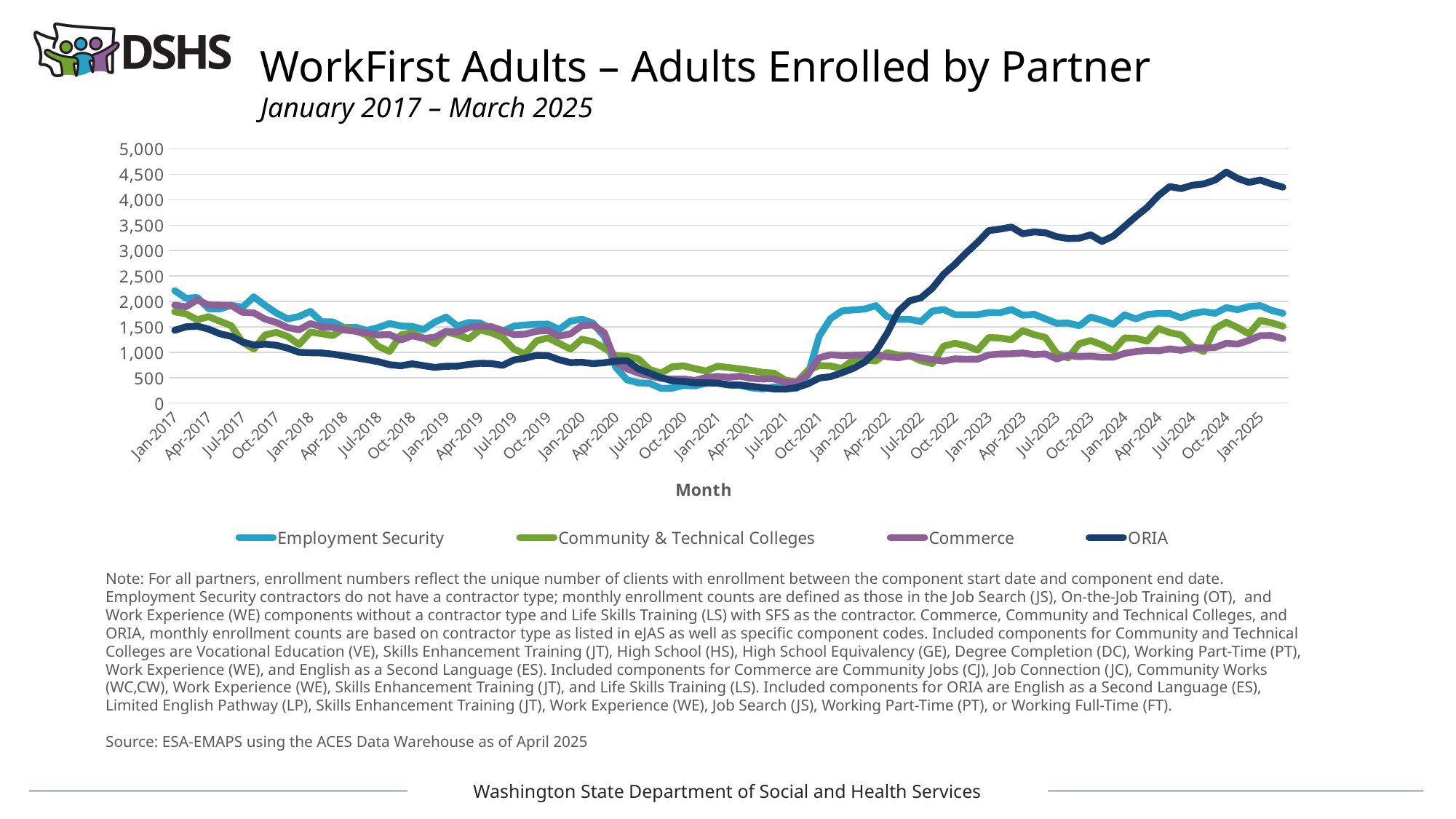
What is the title of the chart on the slide? WorkFirst Adults – Adults Enrolled by Partner How many series does the legend list? 4 Is the value for ORIA in Jan-2017 greater or less than 2,000? less Which series has the lowest value in Jan-2017? ORIA Is the value for Employment Security in Oct-2020 greater or less than 1,000? less What kind of chart is shown on the slide? line chart What is the label of the x axis? Month Which series has the highest value in Jan-2025? ORIA In Jan-2017, which is larger: Employment Security or ORIA? Employment Security Is the value for ORIA in Oct-2024 greater or less than 4,000? greater Does the ORIA line rise or fall between Jan-2022 and Jan-2023? rise